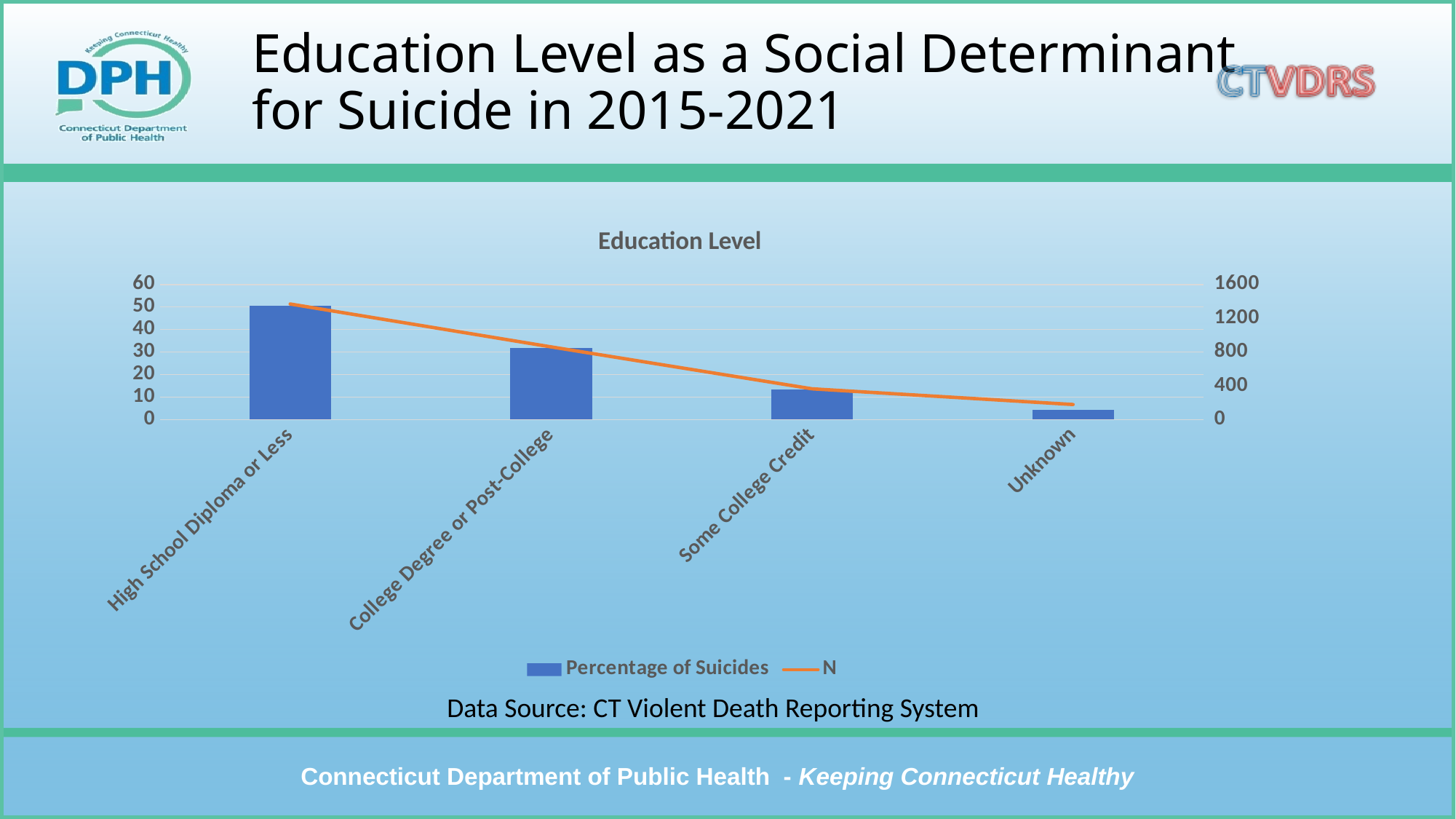
Is the percentage of suicides for High School Diploma or Less greater or less than 40? greater Which education level has the lowest percentage of suicides? Unknown Do the N values rise or fall moving from left to right across the categories? fall Is the N value for Unknown greater or less than 400? less Which education level has the highest percentage of suicides? High School Diploma or Less How many series does the legend list? 2 Is the N value for High School Diploma or Less greater or less than 1200? greater What kind of chart is shown on the slide? A bar chart combined with a line chart Which has a larger percentage of suicides, College Degree or Post-College or Some College Credit? College Degree or Post-College How many education level categories are shown on the x axis? 4